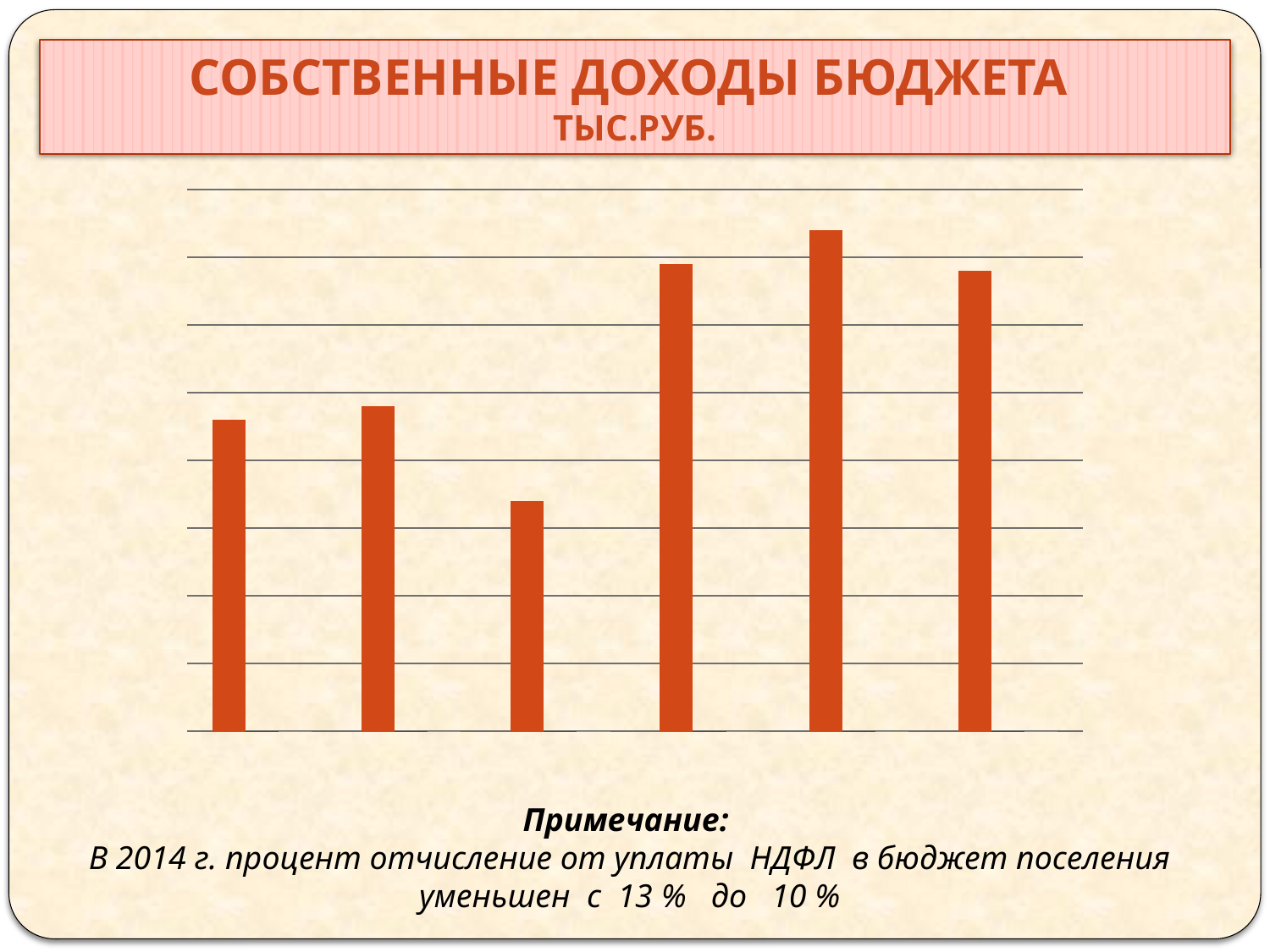
Which bar, counted from the left, is the tallest in the chart? the fifth bar Which bar, counted from the left, is the shortest in the chart? the third bar What colour are the bars in the chart? orange-red Which is taller: the third bar from the left or the sixth bar from the left? the sixth bar Do the bar heights rise or fall from the fifth bar to the sixth bar? fall What kind of chart is shown on the slide? bar chart Which is taller: the first bar from the left or the fourth bar from the left? the fourth bar How many bars are plotted in the chart? 6 Do the bar heights rise or fall from the third bar to the fourth bar? rise Which is taller: the second bar from the left or the fifth bar from the left? the fifth bar What is the title of the chart on the slide? СОБСТВЕННЫЕ ДОХОДЫ БЮДЖЕТА ТЫС.РУБ.